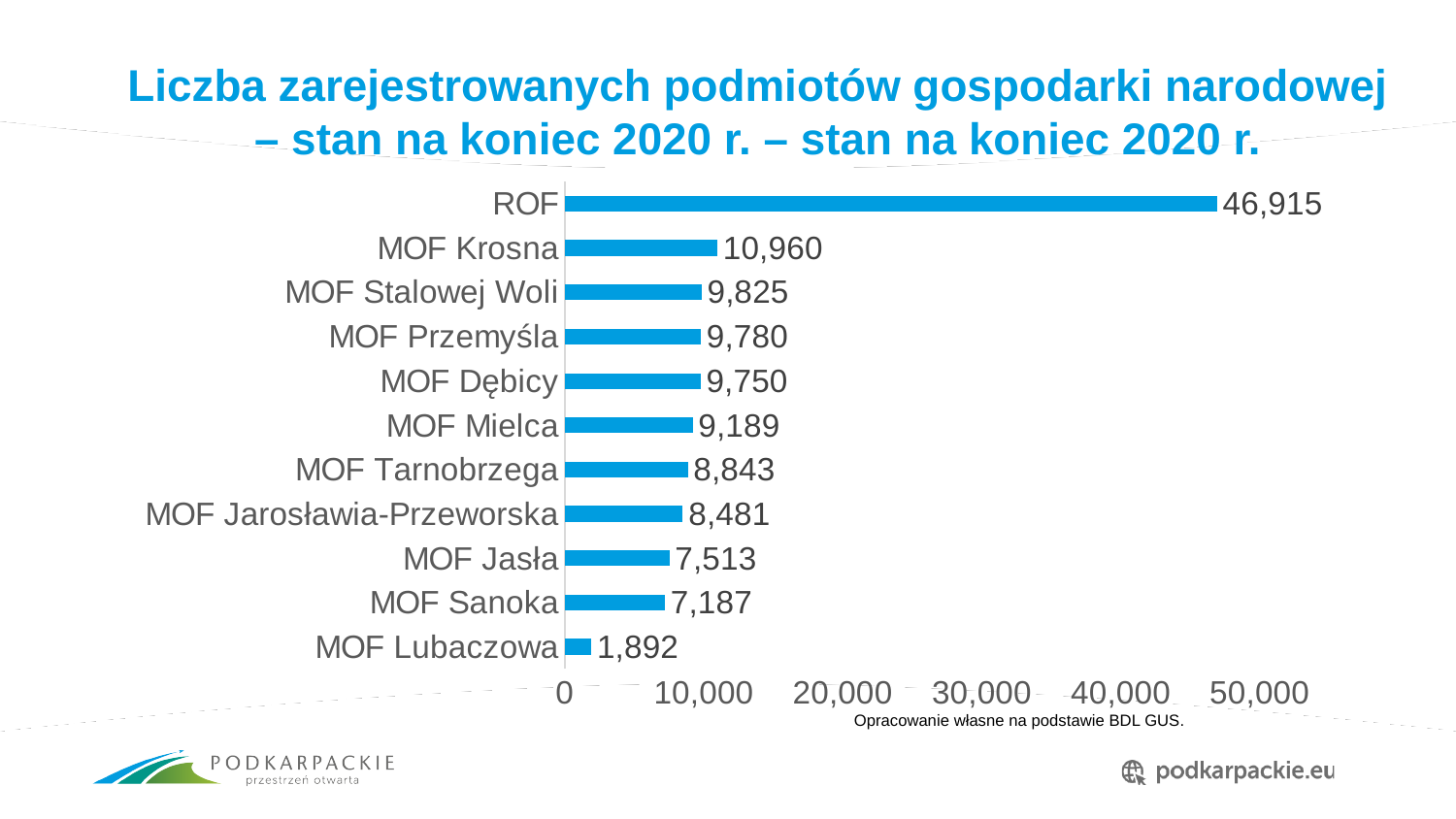
What kind of chart is shown on the slide? bar chart What is the source note printed below the chart? Opracowanie własne na podstawie BDL GUS. Which is larger, the value for MOF Mielca or the value for MOF Jarosławia-Przeworska? MOF Mielca What is the difference between the values for ROF and MOF Krosna? 35,955 What is the value for MOF Lubaczowa? 1,892 Which category has the lowest value? MOF Lubaczowa Which category has the highest value? ROF What is the value for MOF Tarnobrzega? 8,843 Is the value for MOF Stalowej Woli greater or less than 10,000? less What is the difference between the values for MOF Jasła and MOF Sanoka? 326 How many categories are shown in the chart? 11 What is the value for MOF Krosna? 10,960